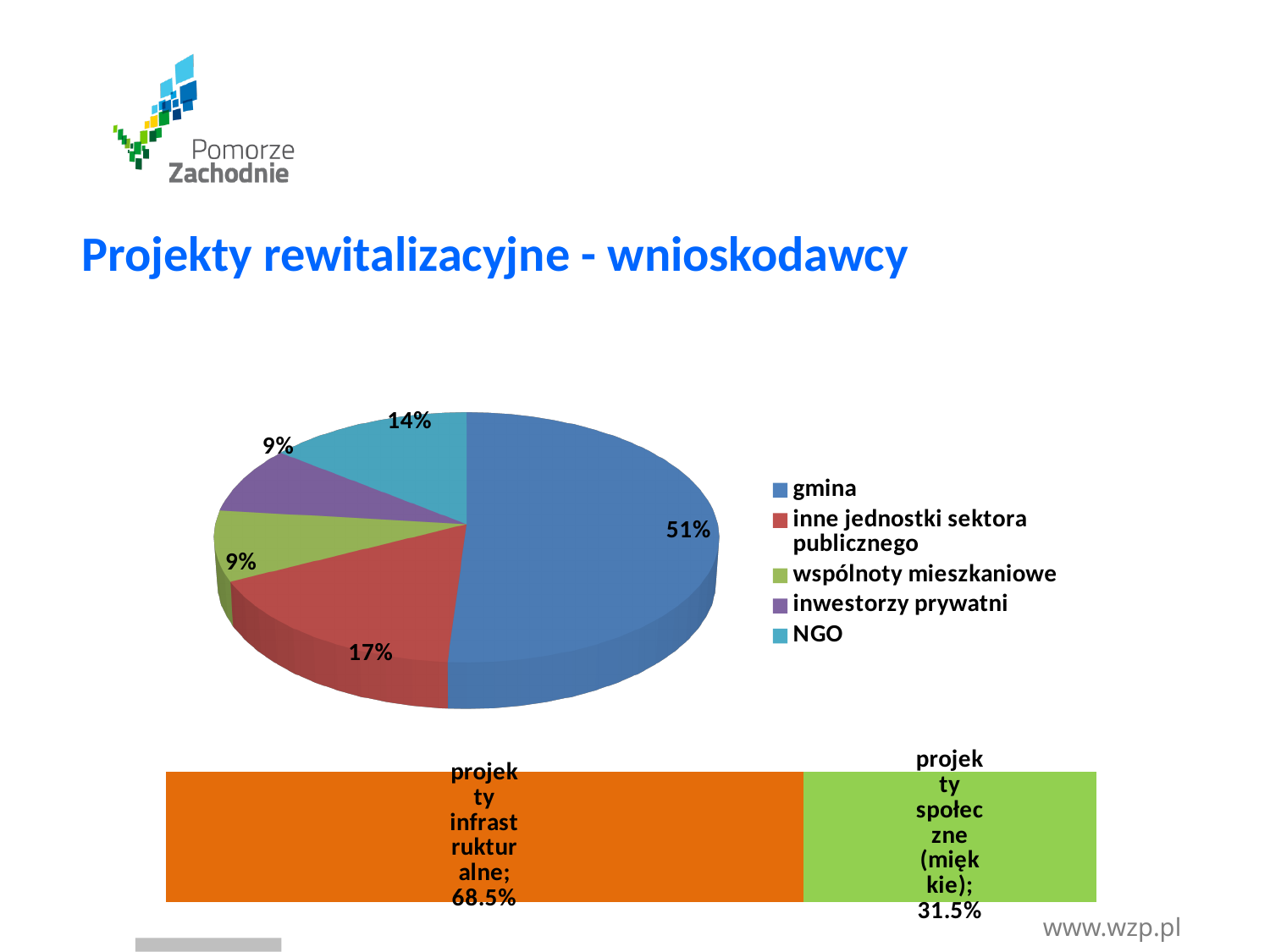
In the pie chart, what share does NGO have? 14% In the pie chart, what share does gmina have? 51% In the pie chart, which category has the largest share? gmina In the pie chart, what colour is the gmina slice? blue In the pie chart, what is the difference between the shares of gmina and inne jednostki sektora publicznego? 34% In the pie chart, which is larger: the share of NGO or the share of inwestorzy prywatni? NGO In the pie chart, how many slices are there? 5 In the pie chart, what share does inne jednostki sektora publicznego have? 17% In the pie chart, how many entries does the legend list? 5 In the bar chart at the bottom of the slide, what is the value for projekty społeczne (miękkie)? 31.5% What type of chart is shown at the bottom of the slide? bar chart In the bar chart at the bottom of the slide, what is the value for projekty infrastrukturalne? 68.5%